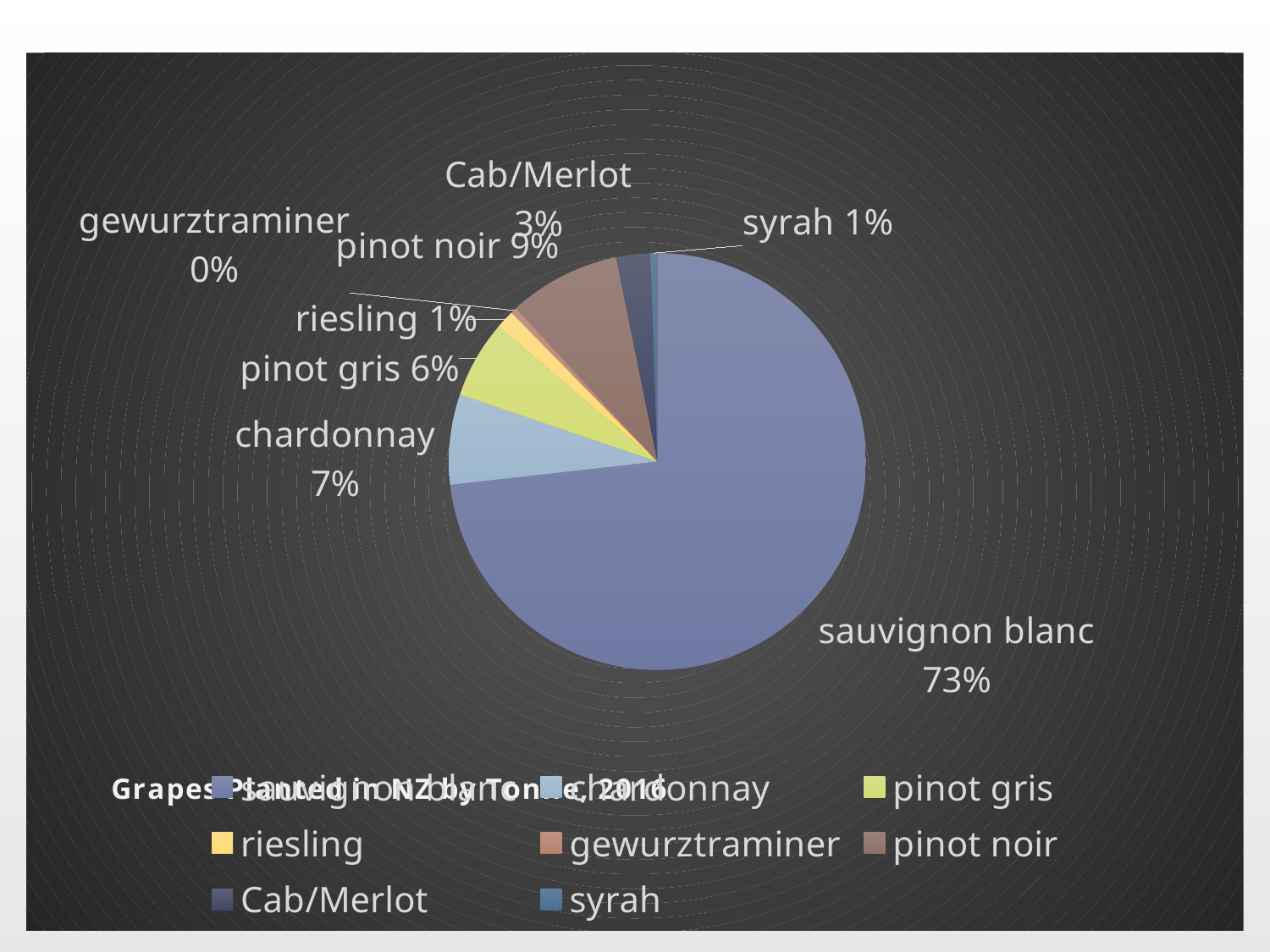
Which grape variety has the largest slice of the pie? sauvignon blanc What share of the pie does sauvignon blanc have? 73% What share of the pie does pinot noir have? 9% How many grape varieties does the legend list? 8 What type of chart is shown on the slide? pie chart What share of the pie does pinot gris have? 6% Which grape variety has the smallest slice of the pie? gewurztraminer Which has a larger share, pinot noir or chardonnay? pinot noir What is the difference in percentage points between sauvignon blanc and pinot noir? 64